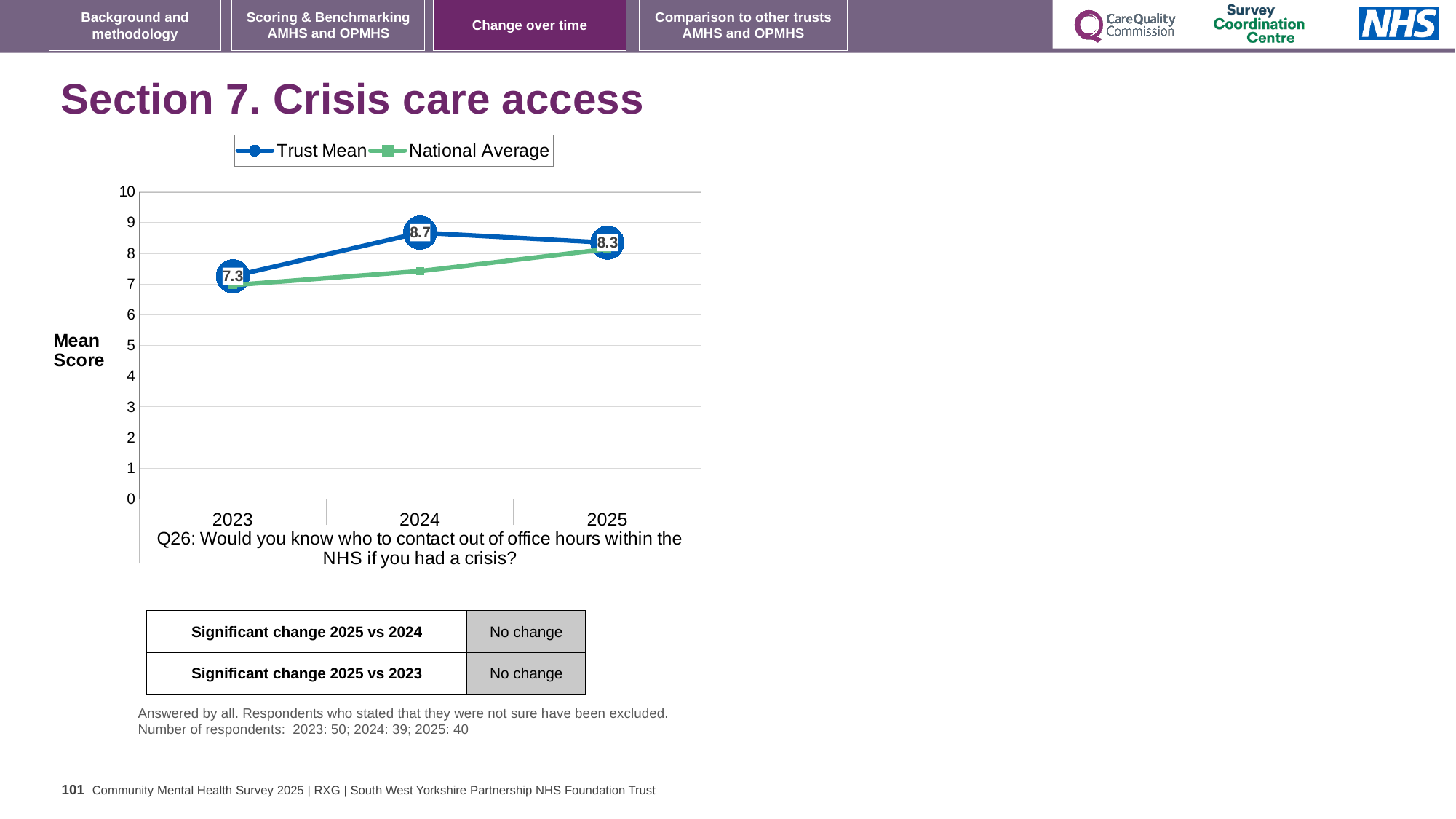
How many series does the legend list? 2 Is the National Average value for 2023 greater or less than 8? less How many years are plotted on the x axis? 3 Which is larger, the Trust Mean in 2025 or the Trust Mean in 2023? 2025 In which year is the Trust Mean highest? 2024 What is the Trust Mean value for 2025? 8.3 What is the difference between the Trust Mean in 2024 and in 2023? 1.4 What kind of chart is shown on the slide? Line chart Is the National Average value for 2025 greater or less than 7? greater What is the Trust Mean value for 2024? 8.7 What is the Trust Mean value for 2023? 7.3 In which year is the Trust Mean lowest? 2023